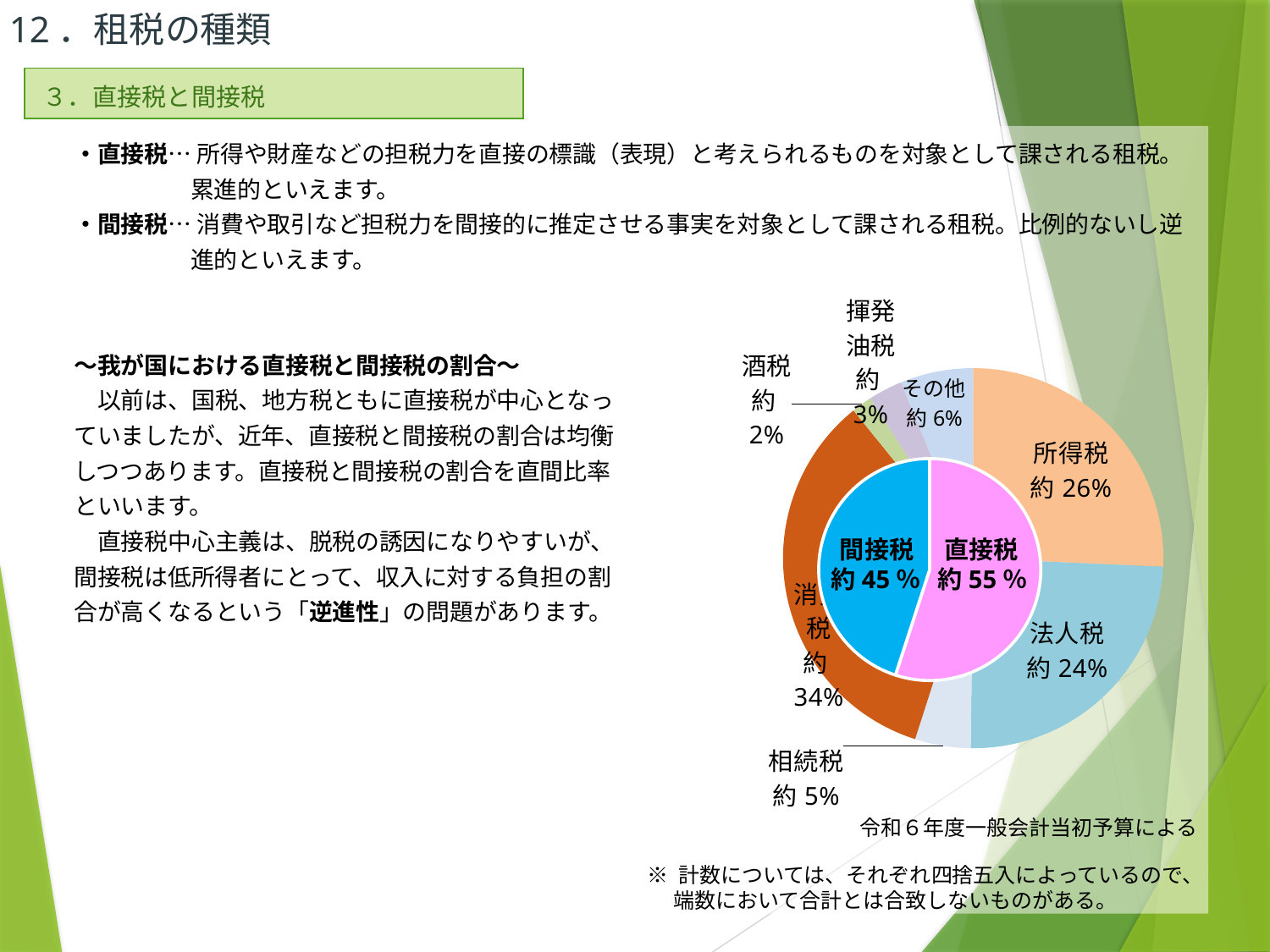
Which tax category in the outer ring has the largest share? 消費税 What share is shown for 相続税? 約 5% What share is shown for 消費税? 約 34% What share is shown for 揮発油税? 約 3% What kind of chart is shown on the slide? pie chart (doughnut) In the inner ring, what share is shown for 直接税? 約 55% What share is shown for 法人税? 約 24% What share is shown for 酒税? 約 2% In the inner ring, what share is shown for 間接税? 約 45% Which tax category in the outer ring has the smallest share? 酒税 How many tax categories are labelled in the outer ring? 7 What share of the outer ring is labelled for 所得税? 約 26%